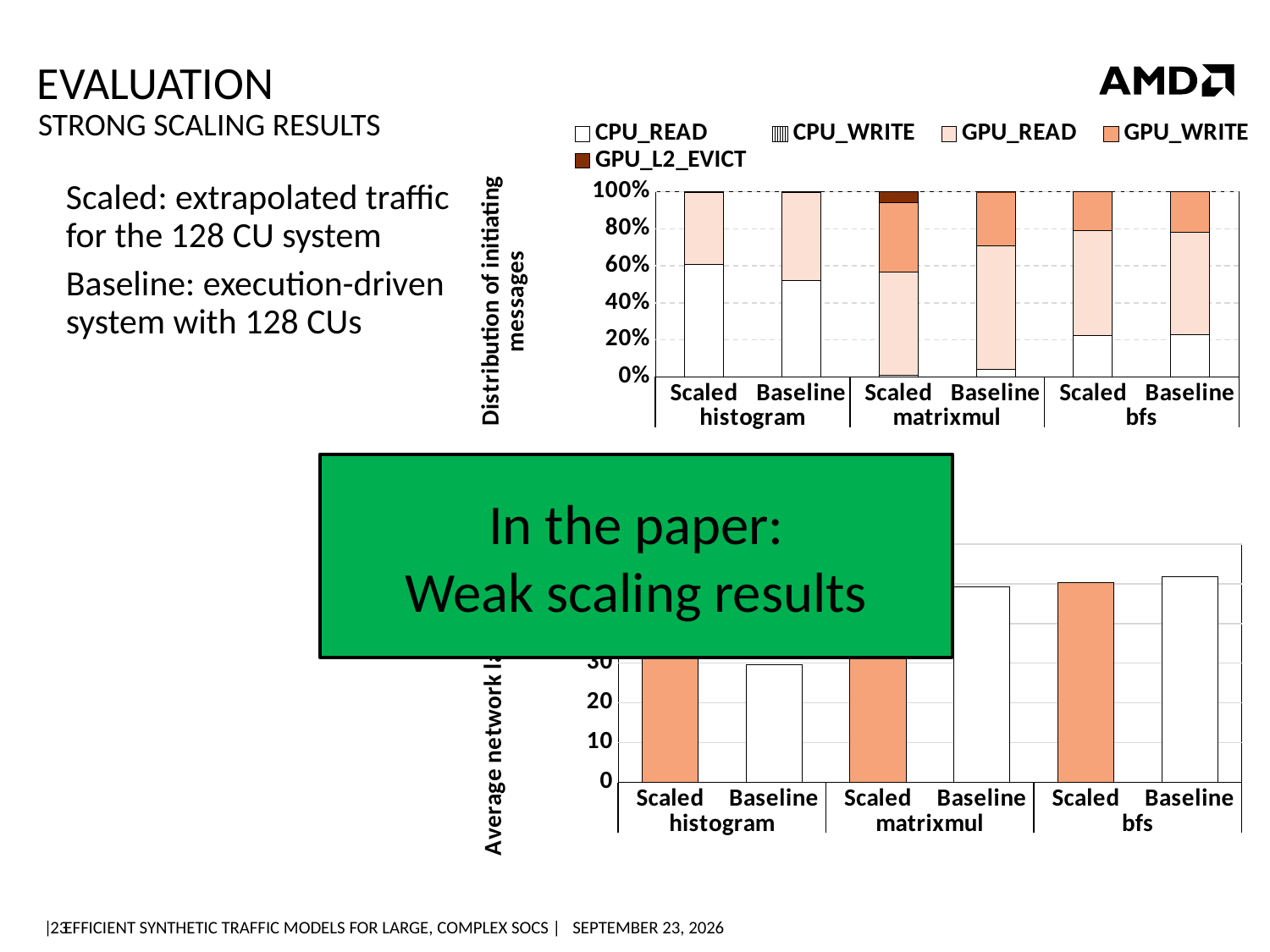
How many series does the legend of the top chart (Distribution of initiating messages) list? 5 In the top chart (Distribution of initiating messages), is the CPU_READ portion of the Scaled histogram bar greater or less than 40%? greater In the top chart (Distribution of initiating messages), is the CPU_READ portion of the Scaled matrixmul bar greater or less than 20%? less In the top chart (Distribution of initiating messages), how many benchmark groups are shown on the x axis? 3 In the bottom chart (Average network latency), how many bars are plotted? 6 In the top chart (Distribution of initiating messages), which has a larger CPU_READ portion: the Scaled histogram bar or the Scaled bfs bar? Scaled histogram In the top chart (Distribution of initiating messages), which benchmark's Scaled bar includes a GPU_L2_EVICT segment? matrixmul In the bottom chart (Average network latency), is the value for Scaled bfs greater or less than 30? greater In the bottom chart (Average network latency), which is larger: the Baseline value for histogram or the Baseline value for bfs? Baseline bfs What kind of chart is the top chart on the slide (Distribution of initiating messages)? Stacked bar chart What kind of chart is the bottom chart on the slide (Average network latency)? Bar chart In the top chart (Distribution of initiating messages), which legend entry is listed first? CPU_READ